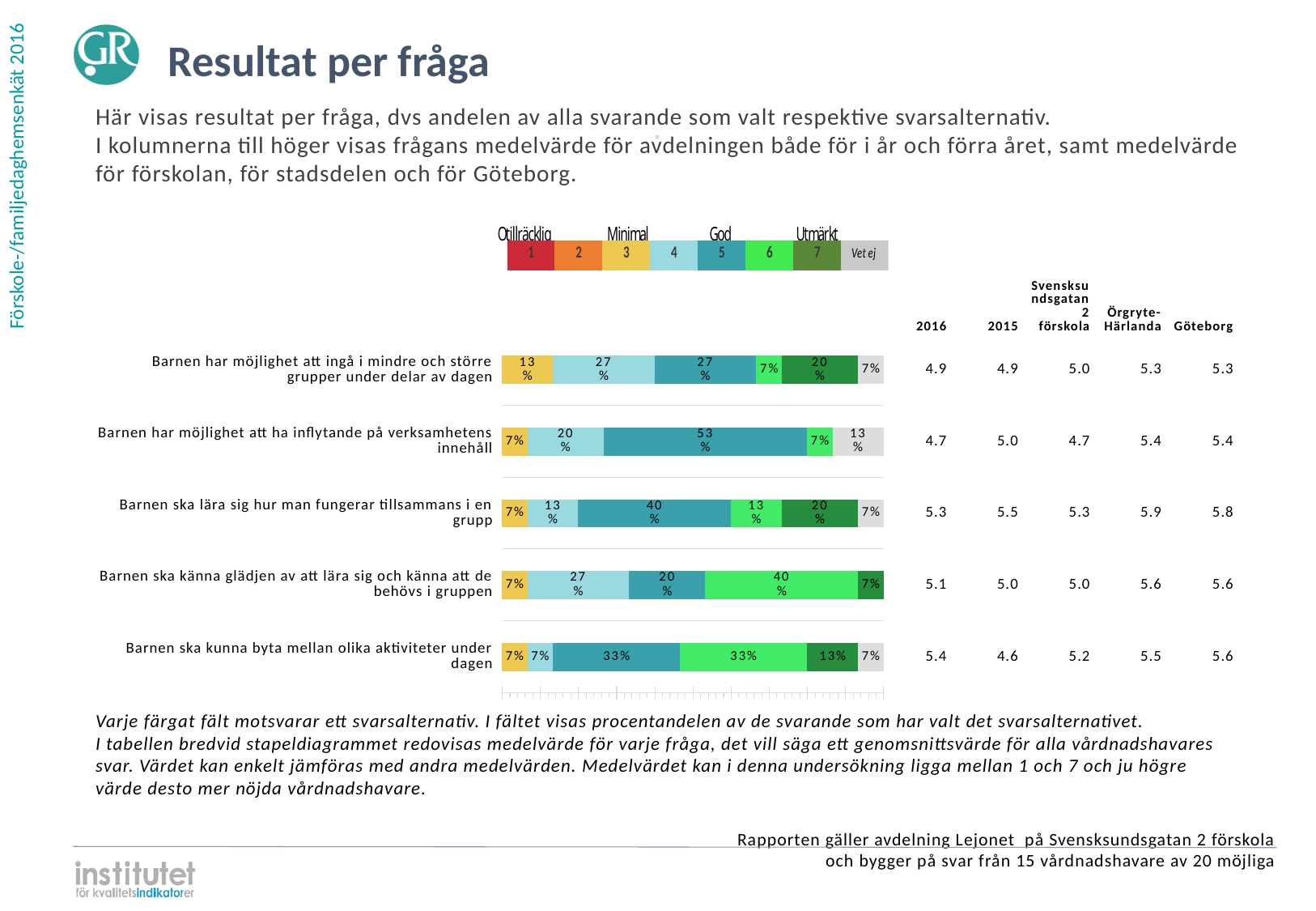
What percentage chose alternative 7 (Utmärkt) for "Barnen ska lära sig hur man fungerar tillsammans i en grupp"? 20% For "Barnen ska kunna byta mellan olika aktiviteter under dagen", what is the difference between the share for alternative 5 and the share for alternative 7? 20% What kind of chart is shown on the slide? Stacked bar chart For "Barnen ska lära sig hur man fungerar tillsammans i en grupp", what is the combined share of alternatives 6 and 7? 33% Which colour represents answer alternative 1 (Otillräcklig) in the legend? Red Which answer alternative has the largest share for "Barnen har möjlighet att ha inflytande på verksamhetens innehåll"? 5 (God) How many questions (bars) are plotted in the chart? 5 For "Barnen har möjlighet att ingå i mindre och större grupper under delar av dagen", which is larger: the share for alternative 4 or the share for alternative 7? Alternative 4 What percentage chose alternative 6 for "Barnen ska känna glädjen av att lära sig och känna att de behövs i gruppen"? 40% What percentage of respondents chose alternative 5 (God) for "Barnen har möjlighet att ha inflytande på verksamhetens innehåll"? 53% What percentage answered "Vet ej" for "Barnen har möjlighet att ha inflytande på verksamhetens innehåll"? 13% How many answer alternatives does the legend above the chart list? 8